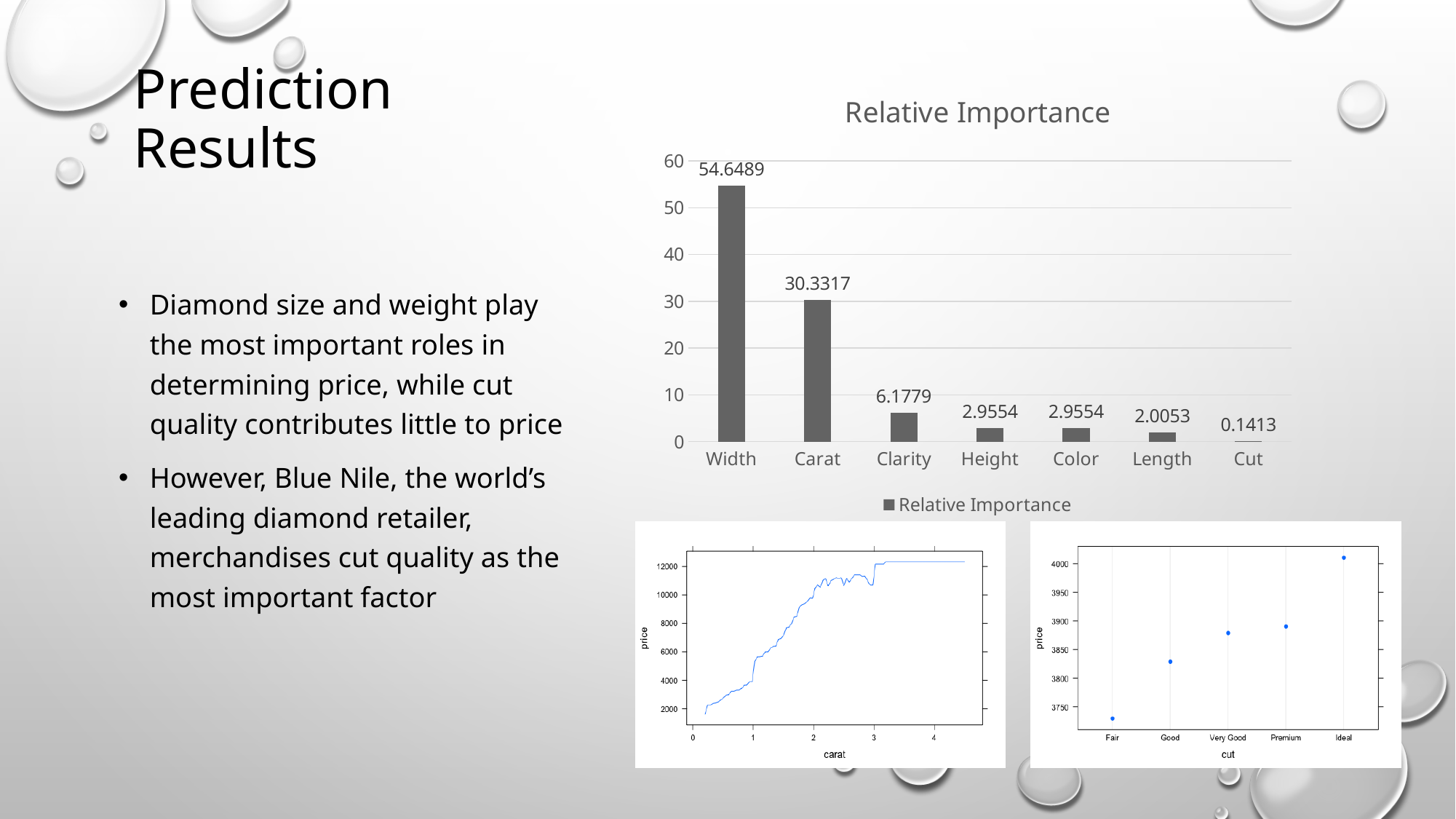
In the Relative Importance chart, what is the value for Width? 54.6489 In the bottom-right chart of price against cut, is the price for Ideal greater or less than 4000? greater In the Relative Importance chart, how many series does the legend list? 1 In the bottom-left chart of price against carat, does price rise or fall as carat increases? rise In the Relative Importance chart, which is larger, the value for Clarity or the value for Length? Clarity In the Relative Importance chart, what is the difference between the values for Width and Carat? 24.3172 In the Relative Importance chart, which category has the lowest value? Cut What kind of chart is the Relative Importance chart? bar chart In the Relative Importance chart, which category has the highest value? Width In the Relative Importance chart, what is the value for Clarity? 6.1779 In the bottom-right chart of price against cut, which cut category has the highest price? Ideal In the Relative Importance chart, how many categories are shown on the x axis? 7